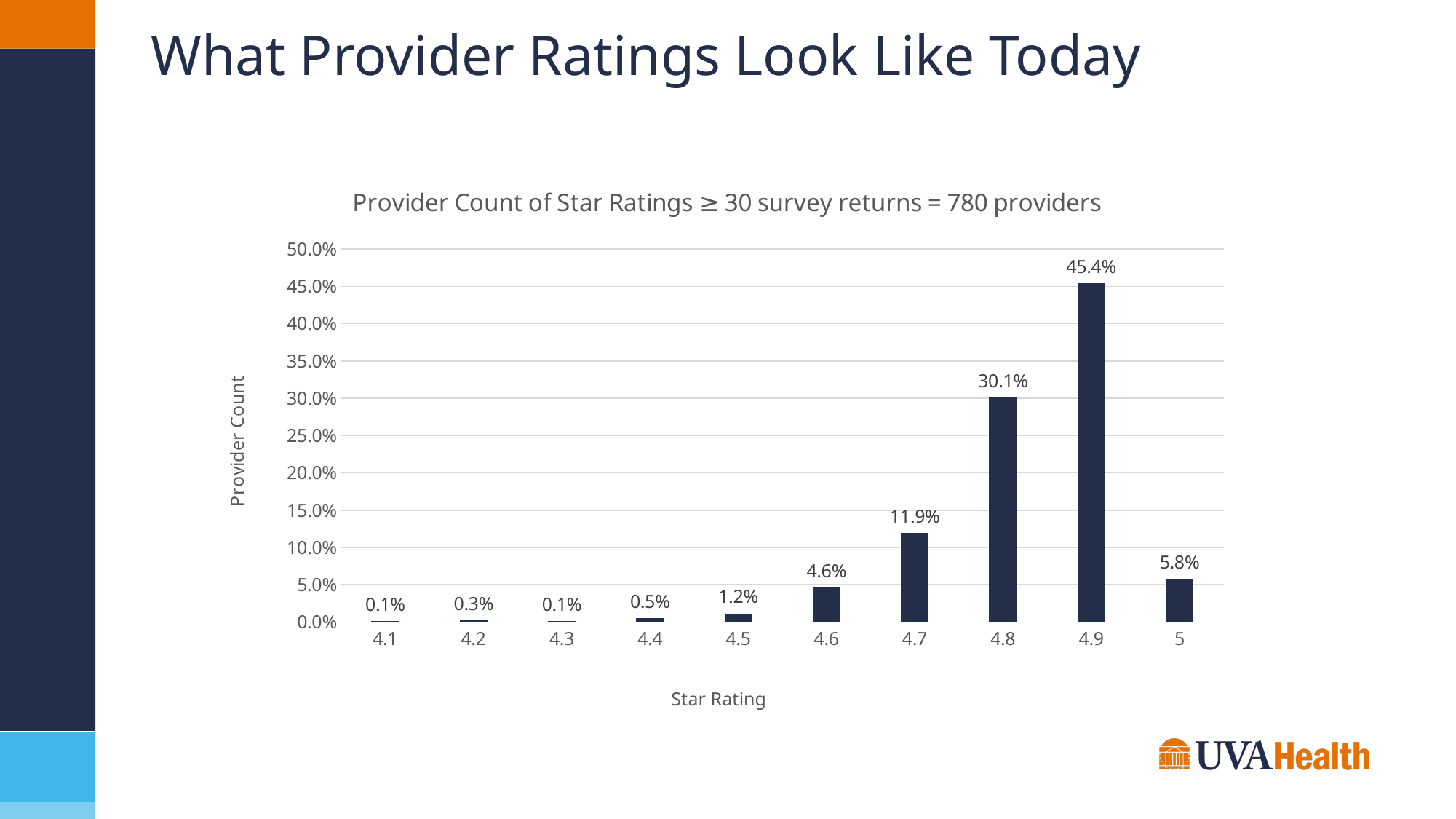
What is the value for star rating 4.7? 11.9% What is the value for star rating 5? 5.8% Is the value for star rating 4.8 greater or less than 25.0%? greater Which is larger, the value for star rating 4.6 or star rating 5? 5 What kind of chart is shown on the slide? bar chart How many star rating categories are shown on the x axis? 10 Which star rating has the highest provider count? 4.9 What is the value for star rating 4.9? 45.4% What is the title of the chart? Provider Count of Star Ratings ≥ 30 survey returns = 780 providers What is the label of the x axis? Star Rating What is the difference between the values for star ratings 4.7 and 4.6? 7.3% What is the difference between the values for star ratings 4.9 and 4.8? 15.3%